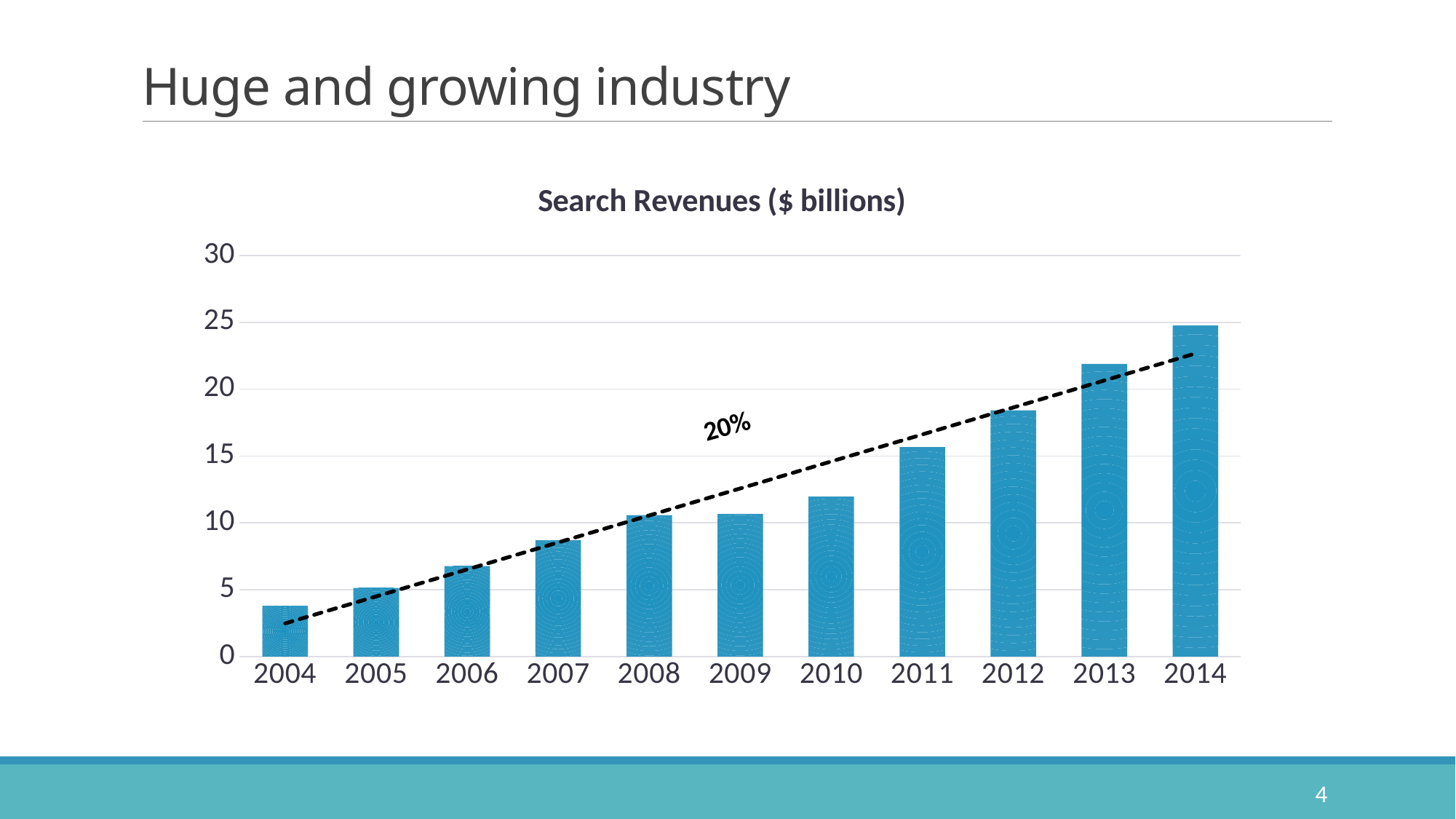
Which year has the larger search revenue, 2011 or 2013? 2013 What percentage label is printed next to the dashed trend line? 20% What is the title of the chart? Search Revenues ($ billions) Is the value for 2007 greater or less than 10? less Is the value for 2014 greater or less than 20? greater Is the value for 2004 greater or less than 5? less Which year has the lowest search revenue? 2004 How many years are shown on the x axis of the chart? 11 Do search revenues generally rise or fall from 2004 to 2014? Rise What kind of chart is shown on the slide? Bar chart Which year has the highest search revenue? 2014